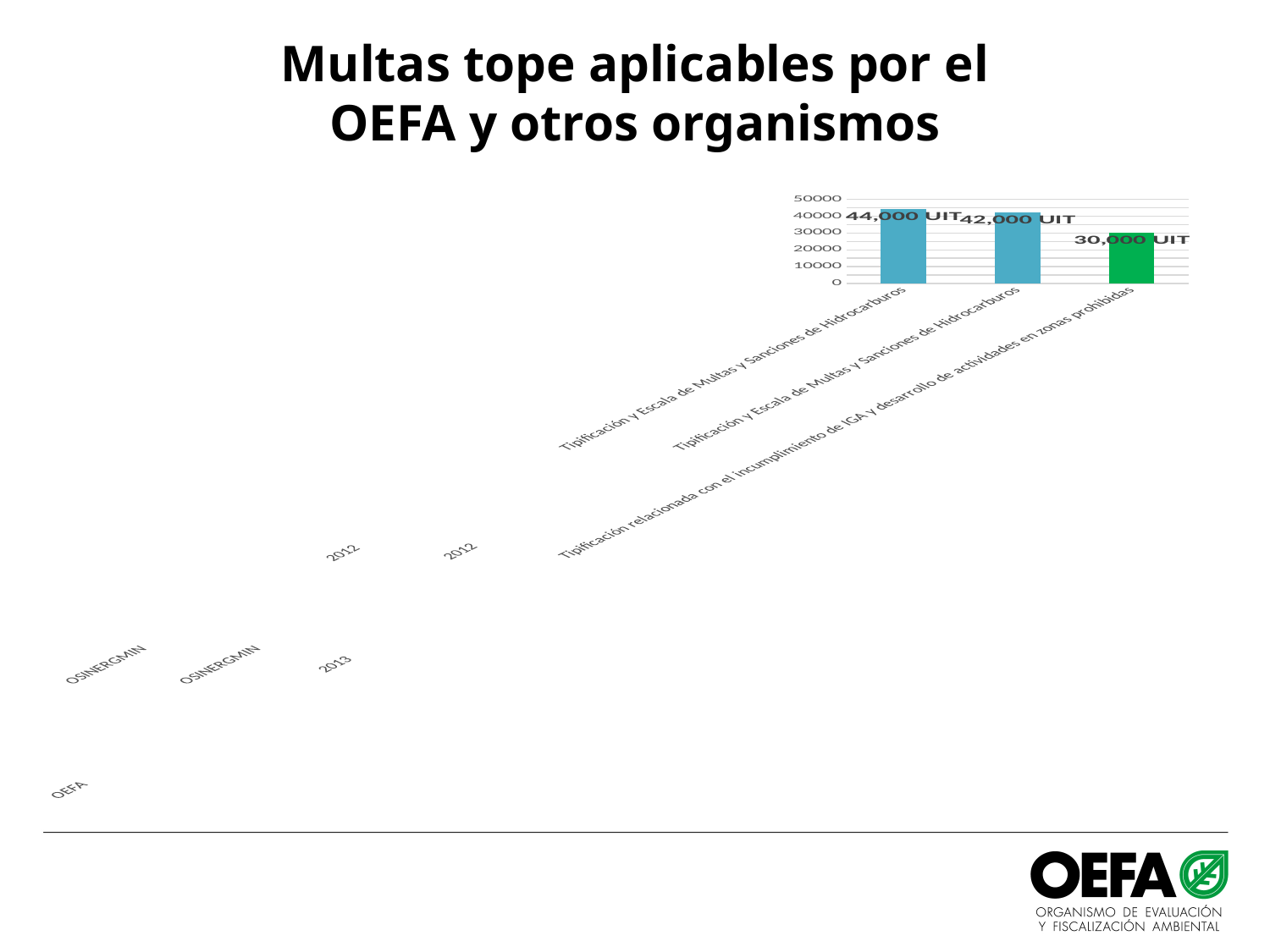
What is the value of the first (leftmost) bar in the chart? 44,000 UIT What is the difference between the first bar and the second bar in the chart? 2,000 UIT Is the value of the green bar greater or less than 40000? less What is the difference between the first bar (44,000 UIT) and the green bar (30,000 UIT)? 14,000 UIT Which bar has the highest value in the chart? the first bar (44,000 UIT) Which category has the lowest value in the chart? Tipificación relacionada con el incumplimiento de IGA y desarrollo de actividades en zonas prohibidas What is the title of the slide containing the chart? Multas tope aplicables por el OEFA y otros organismos Which is larger, the second bar or the green bar? the second bar What is the value of the second bar in the chart? 42,000 UIT What is the value of the green bar for 'Tipificación relacionada con el incumplimiento de IGA y desarrollo de actividades en zonas prohibidas'? 30,000 UIT What type of chart is shown on the slide? bar chart How many bars are plotted in the chart? 3